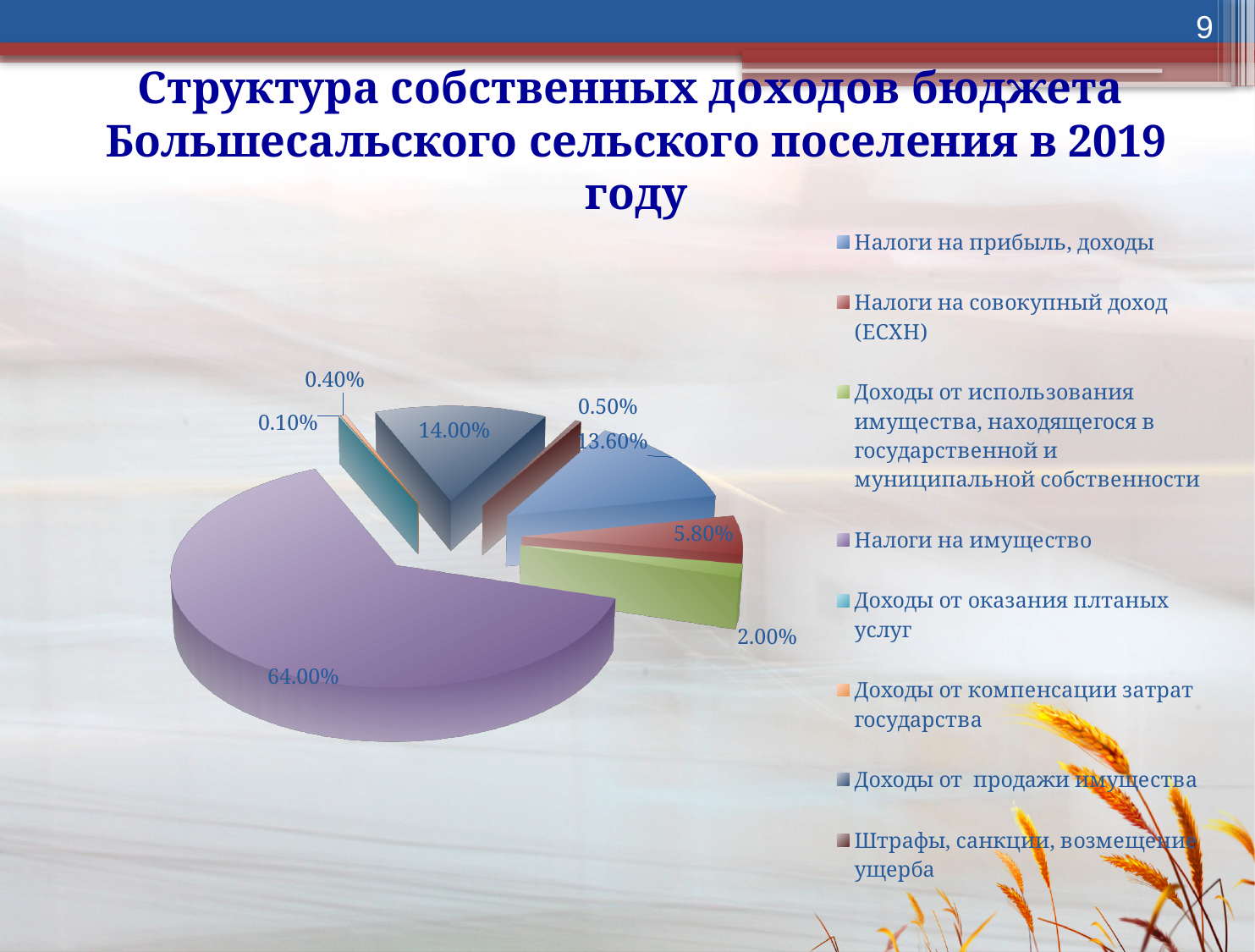
What share of the pie is labelled for Штрафы, санкции, возмещение ущерба? 0.50% What share of the pie is labelled for Доходы от использования имущества, находящегося в государственной и муниципальной собственности? 2.00% Which is larger: the share for Налоги на прибыль, доходы or the share for Налоги на совокупный доход (ЕСХН)? Налоги на прибыль, доходы What share of the pie is labelled for Налоги на совокупный доход (ЕСХН)? 5.80% What is the smallest percentage label shown on the pie chart? 0.10% How many categories does the legend of the pie chart list? 8 What share of the pie is labelled for Налоги на имущество? 64.00% What share of the pie is labelled for Доходы от продажи имущества? 14.00% What is the difference between the shares for Налоги на имущество and Доходы от продажи имущества? 50.00% What share of the pie is labelled for Налоги на прибыль, доходы? 13.60% What kind of chart is shown on the slide? pie chart Which category has the largest share of the pie chart? Налоги на имущество